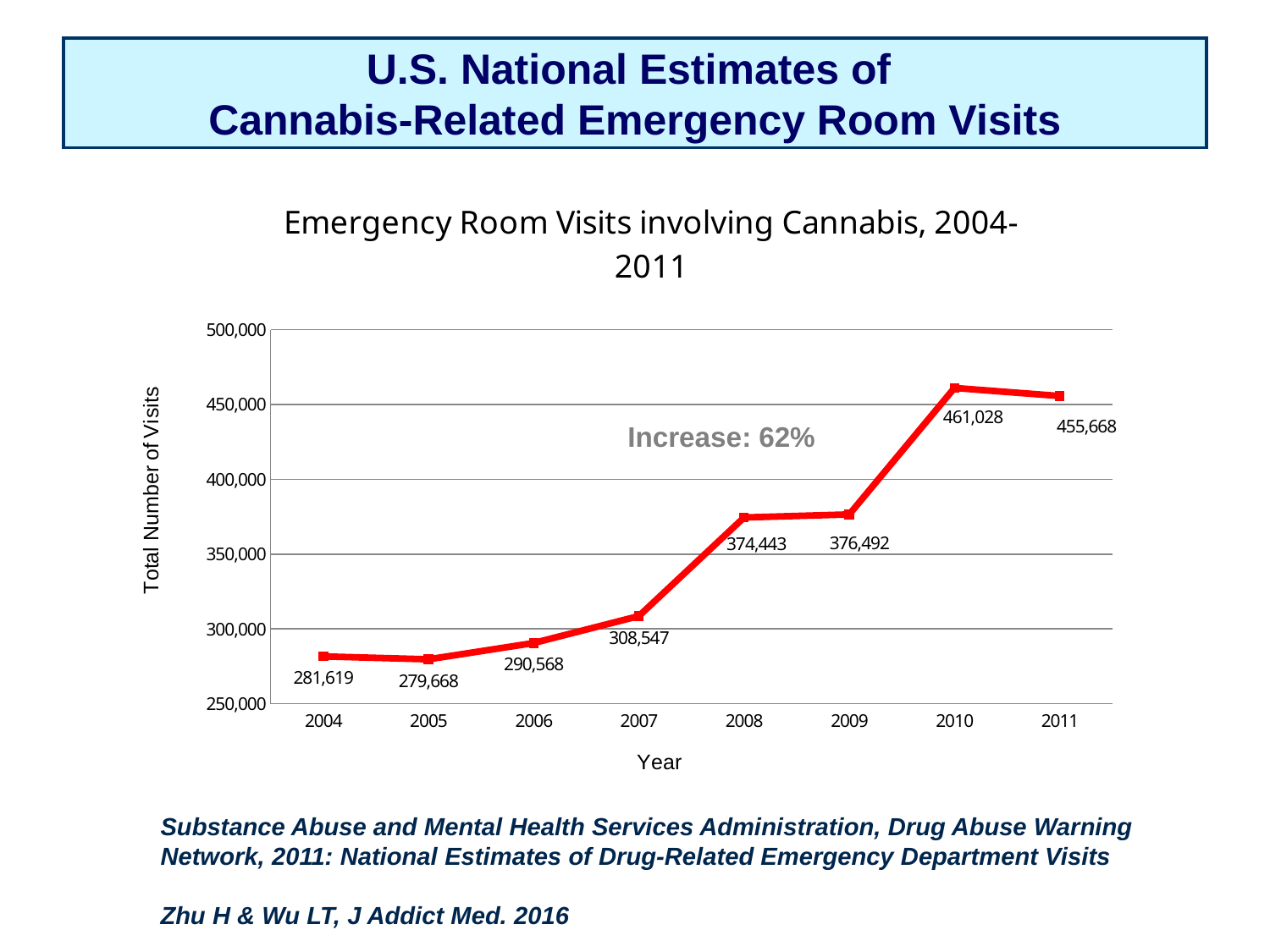
What is the total number of visits shown for 2010? 461,028 What kind of chart is shown on the slide? Line chart What is the difference in visits between 2010 and 2009? 84,536 How many years are plotted on the chart? 8 What is the total number of cannabis-related emergency room visits in 2004? 281,619 What is the value plotted for 2007? 308,547 Which year has the highest number of emergency room visits? 2010 What is the difference in visits between 2011 and 2004? 174,049 What percentage increase is annotated on the chart? 62% Which year has the lowest number of emergency room visits? 2005 Is the value for 2009 greater or less than 400,000? less Which year had more visits, 2008 or 2011? 2011